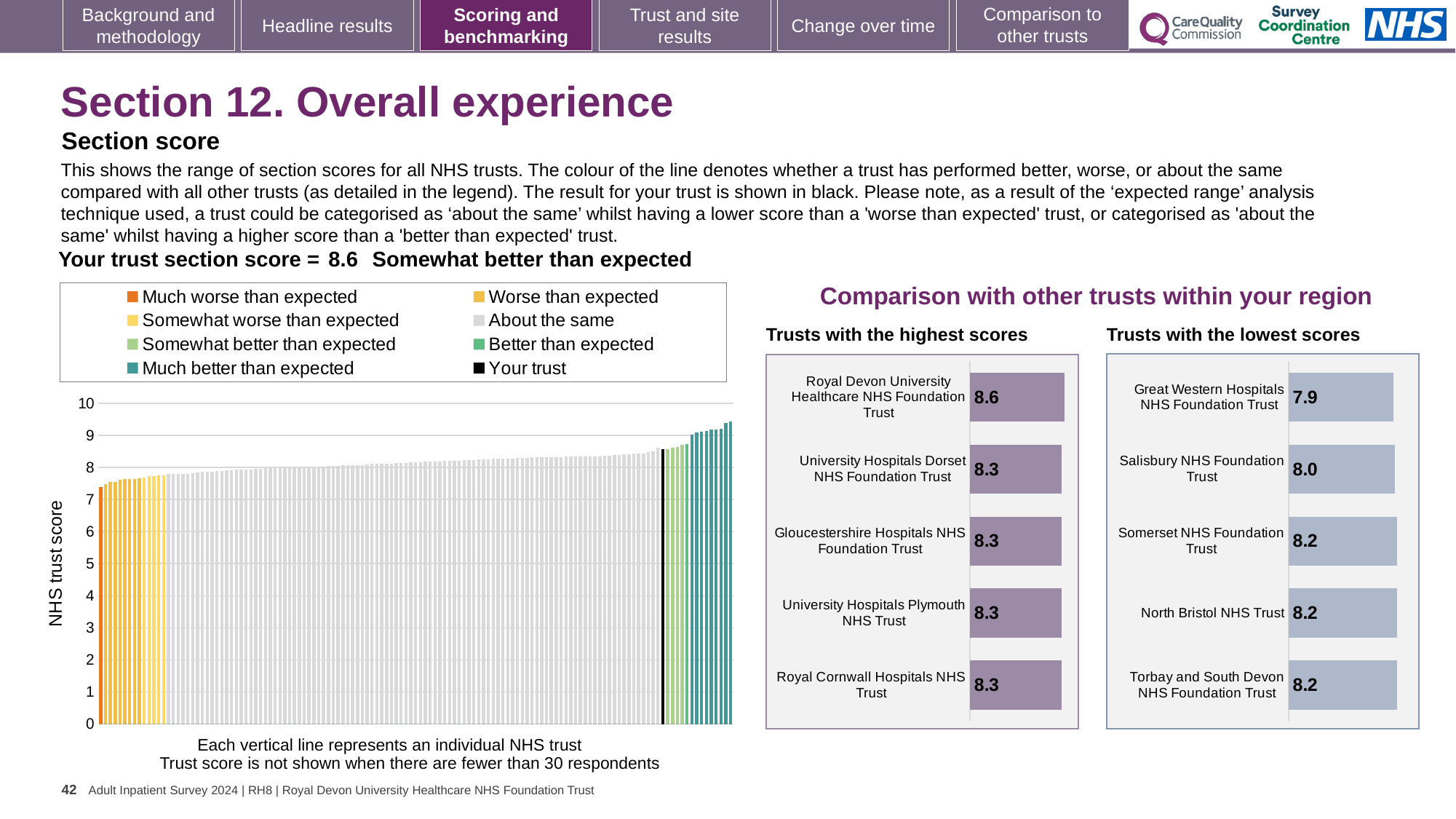
In the 'Trusts with the lowest scores' chart, what is the score for Torbay and South Devon NHS Foundation Trust? 8.2 How many entries does the legend of the 'NHS trust score' chart on the left list? 8 What kind of chart is the large 'NHS trust score' chart on the left of the slide? Bar chart In the 'Trusts with the lowest scores' chart, which has the larger score: Somerset NHS Foundation Trust or Salisbury NHS Foundation Trust? Somerset NHS Foundation Trust In the 'Trusts with the lowest scores' chart, what is the score for Salisbury NHS Foundation Trust? 8.0 In the 'Trusts with the lowest scores' chart, what is the difference between the scores of Salisbury NHS Foundation Trust and Great Western Hospitals NHS Foundation Trust? 0.1 In the 'Trusts with the highest scores' chart, what is the score for Royal Devon University Healthcare NHS Foundation Trust? 8.6 How many trusts are shown in the 'Trusts with the highest scores' chart? 5 In the 'Trusts with the highest scores' chart, what is the difference between the scores of Royal Devon University Healthcare NHS Foundation Trust and University Hospitals Dorset NHS Foundation Trust? 0.3 In the 'Trusts with the lowest scores' chart, which trust has the lowest score? Great Western Hospitals NHS Foundation Trust In the 'Trusts with the highest scores' chart, which trust has the highest score? Royal Devon University Healthcare NHS Foundation Trust In the 'Trusts with the lowest scores' chart, what is the score for Great Western Hospitals NHS Foundation Trust? 7.9